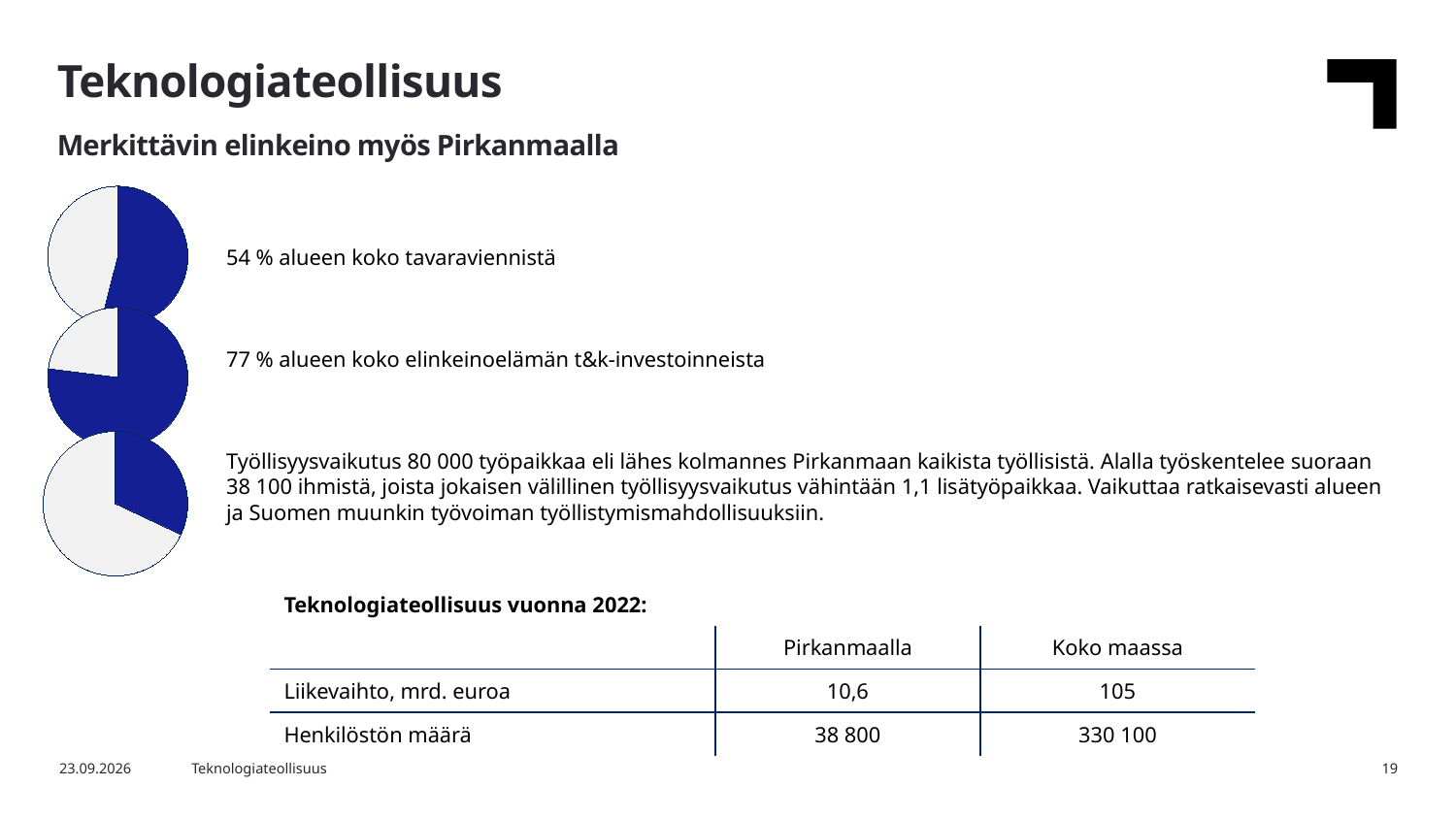
Is the blue slice of the middle pie chart greater or less than 50%? greater What share does the blue slice of the top pie chart represent, according to the text beside it? 54 % What share does the blue slice of the middle pie chart represent, according to the text beside it? 77 % What does the top pie chart's blue slice represent, according to the text beside it? 54 % alueen koko tavaraviennistä Is the blue slice of the bottom pie chart greater or less than 50%? less Which pie chart has the largest blue slice? The middle pie chart What kind of charts are shown on the left side of the slide? Pie charts How many pie charts are on the slide? 3 Which pie chart has the smallest blue slice? The bottom pie chart Which is larger: the blue slice of the top pie chart or the blue slice of the bottom pie chart? The blue slice of the top pie chart How many slices does each pie chart have? 2 What colour is the highlighted slice in each pie chart? Blue